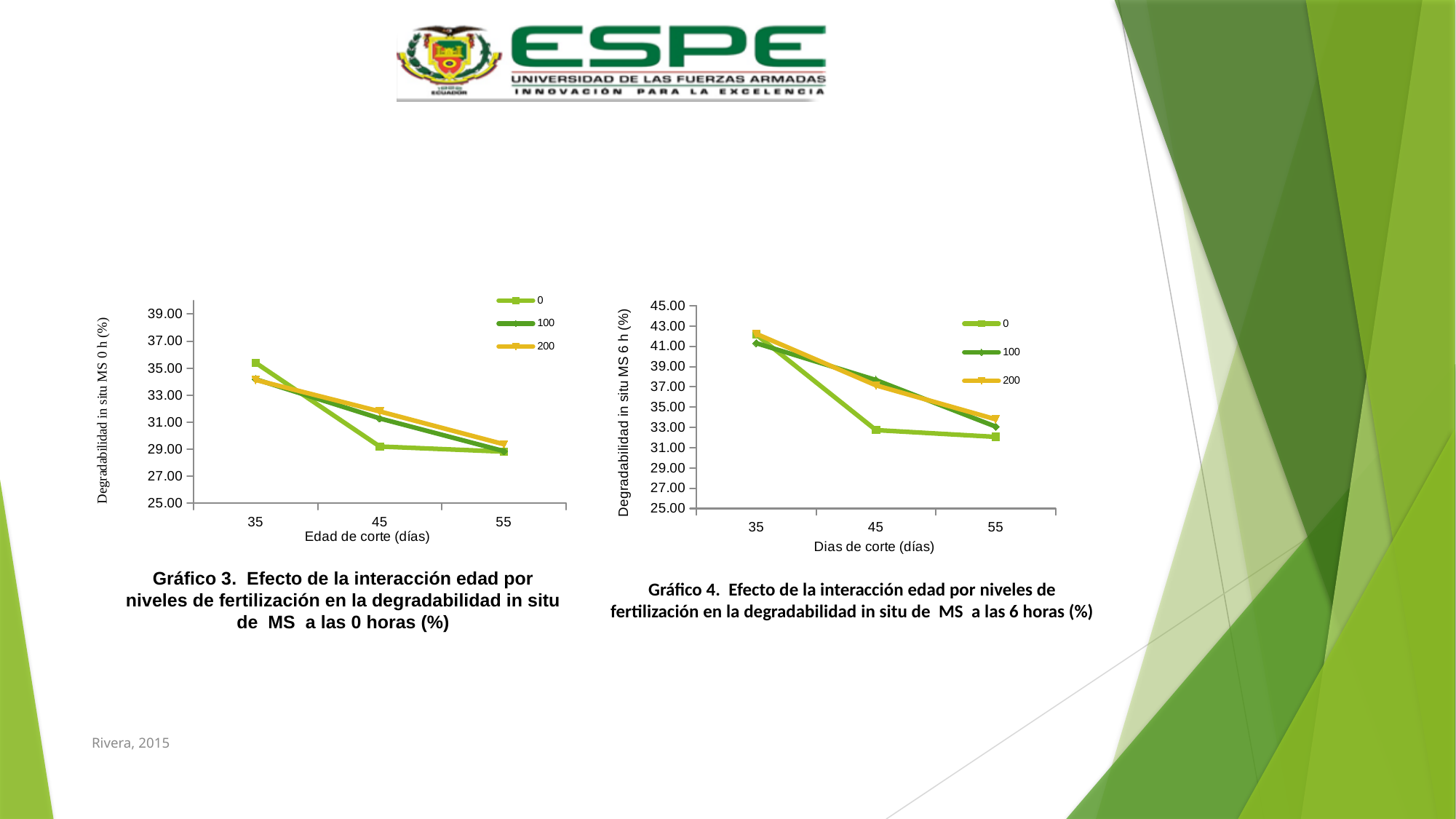
In Gráfico 3, is the value for series 0 at 45 days greater or less than 31.00? less What kind of chart is Gráfico 3 (the left chart)? line chart In Gráfico 3, is the value for series 200 at 45 days greater or less than 31.00? greater How many series does the legend of Gráfico 4 (the right chart) list? 3 In Gráfico 3, which series has the highest value at 35 days? 0 In Gráfico 4, is the value for series 0 at 45 days greater or less than 35.00? less In Gráfico 3, do the values for the series 0 rise or fall as the cutting age increases from 35 to 55 days? fall In Gráfico 4, which series has the lowest value at 45 days? 0 In Gráfico 4, do the values for the series 200 rise or fall from 35 to 55 days? fall How many cutting-age categories are shown on the x axis of Gráfico 3? 3 In Gráfico 4, which is larger at 45 days: the value for series 0 or the value for series 100? 100